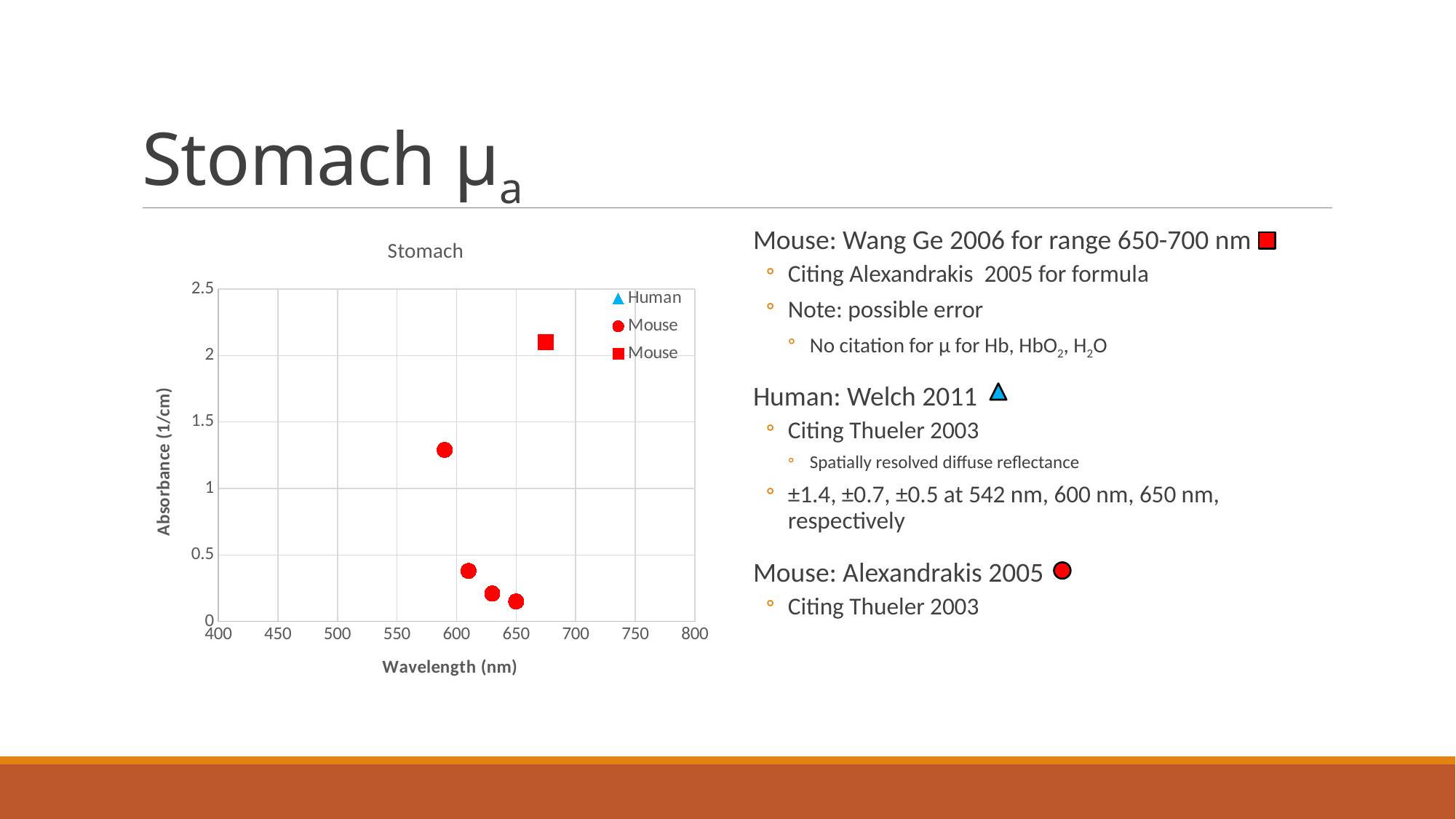
How many series does the legend of the Stomach chart list? 3 How many red circle (Mouse) points are plotted in the Stomach chart? 4 How many Human (triangle) data points are plotted in the Stomach chart? 0 Is the absorbance of the red circle point near 590 nm greater or less than 1? greater Is the absorbance of the red circle point near 650 nm greater or less than 0.5? less Is the absorbance of the red square point greater or less than 2? greater What is the y-axis label of the Stomach chart? Absorbance (1/cm) Among the red circle points, does absorbance rise or fall as wavelength increases? fall Which plotted point has the highest absorbance: the red square or one of the red circles? the red square How many data points are plotted in the Stomach chart? 5 What kind of chart is shown on the slide? scatter chart